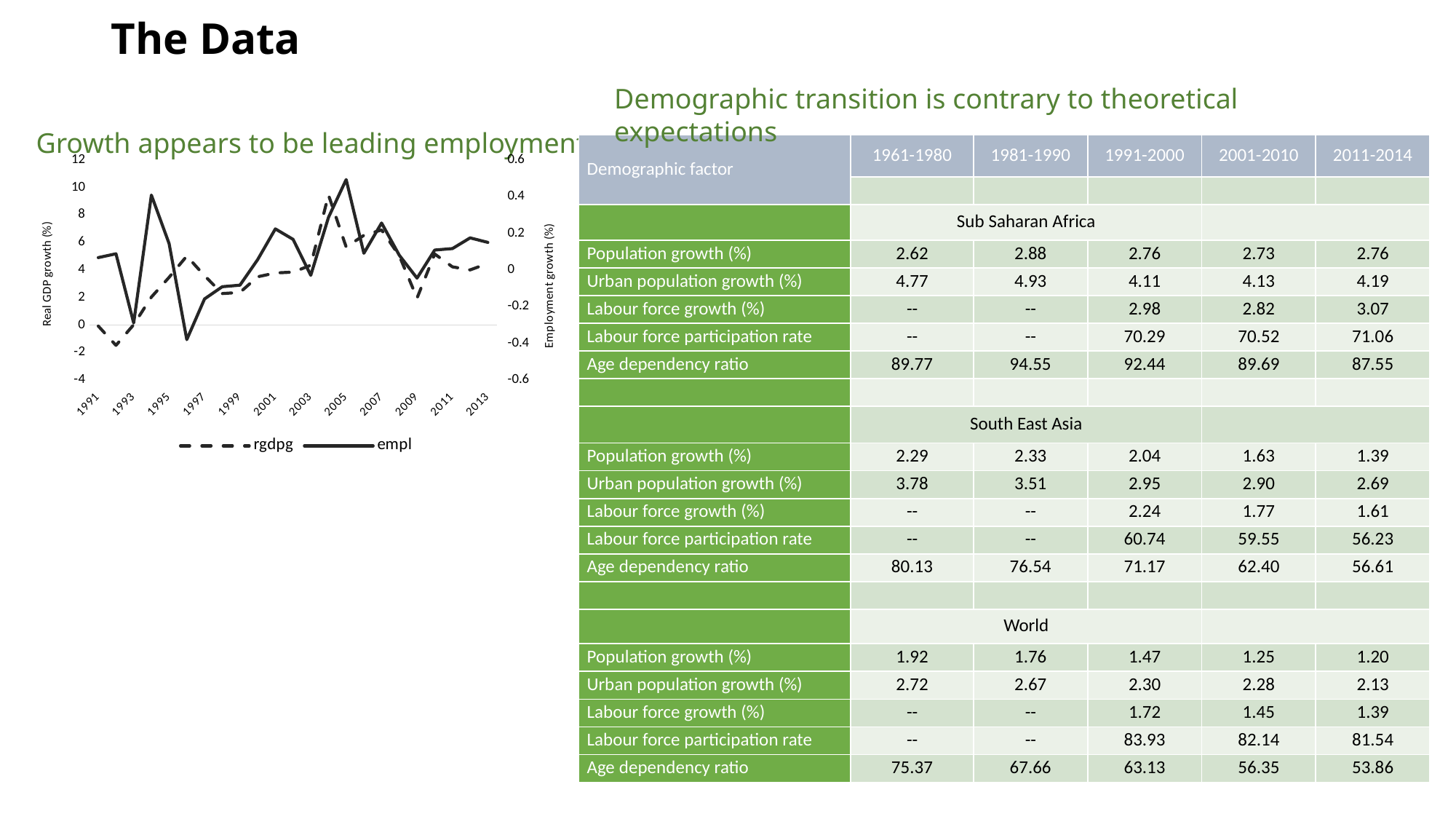
What kind of chart is shown on the left of the slide? line chart In the line chart, in which year does the rgdpg series reach its lowest value? 1992 In the line chart, which is larger for the rgdpg series: the value in 1996 or the value in 1998? 1996 In the line chart, is the rgdpg value for 2004 greater or less than 6? greater In the line chart, is the empl value for 1996 greater or less than 0 on the right axis? less How many series does the legend of the line chart list? 2 In the line chart, in which year does the empl series reach its highest value? 2005 How many year labels are shown on the x axis of the line chart? 12 Which series in the line chart is drawn with a dashed line? rgdpg In the line chart, in which year does the empl series reach its lowest value? 1996 What is the label of the left vertical axis of the line chart? Real GDP growth (%) In the line chart, is the rgdpg value for 1992 greater or less than 0? less